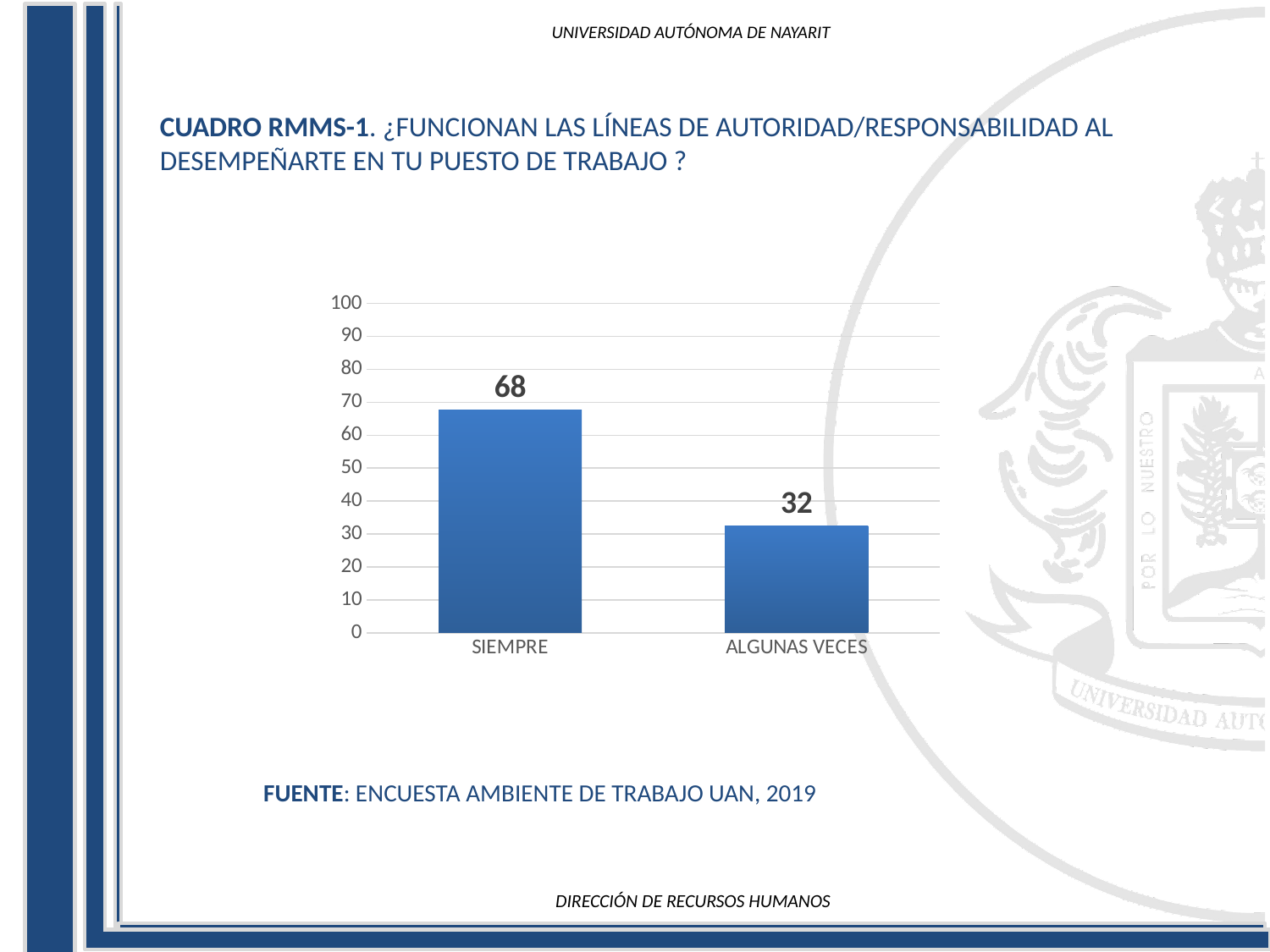
Is the value for ALGUNAS VECES greater or less than 40? less Is the value for SIEMPRE greater or less than 50? greater What is the difference between the values for SIEMPRE and ALGUNAS VECES? 36 Which is larger, the value for SIEMPRE or the value for ALGUNAS VECES? SIEMPRE What is the source cited below the chart? ENCUESTA AMBIENTE DE TRABAJO UAN, 2019 Which category has the lowest value? ALGUNAS VECES Which category has the highest value? SIEMPRE What kind of chart is shown on the slide? bar chart What is the value for ALGUNAS VECES? 32 What is the value for SIEMPRE? 68 What is the maximum value shown on the y axis? 100 How many categories are shown on the x axis? 2